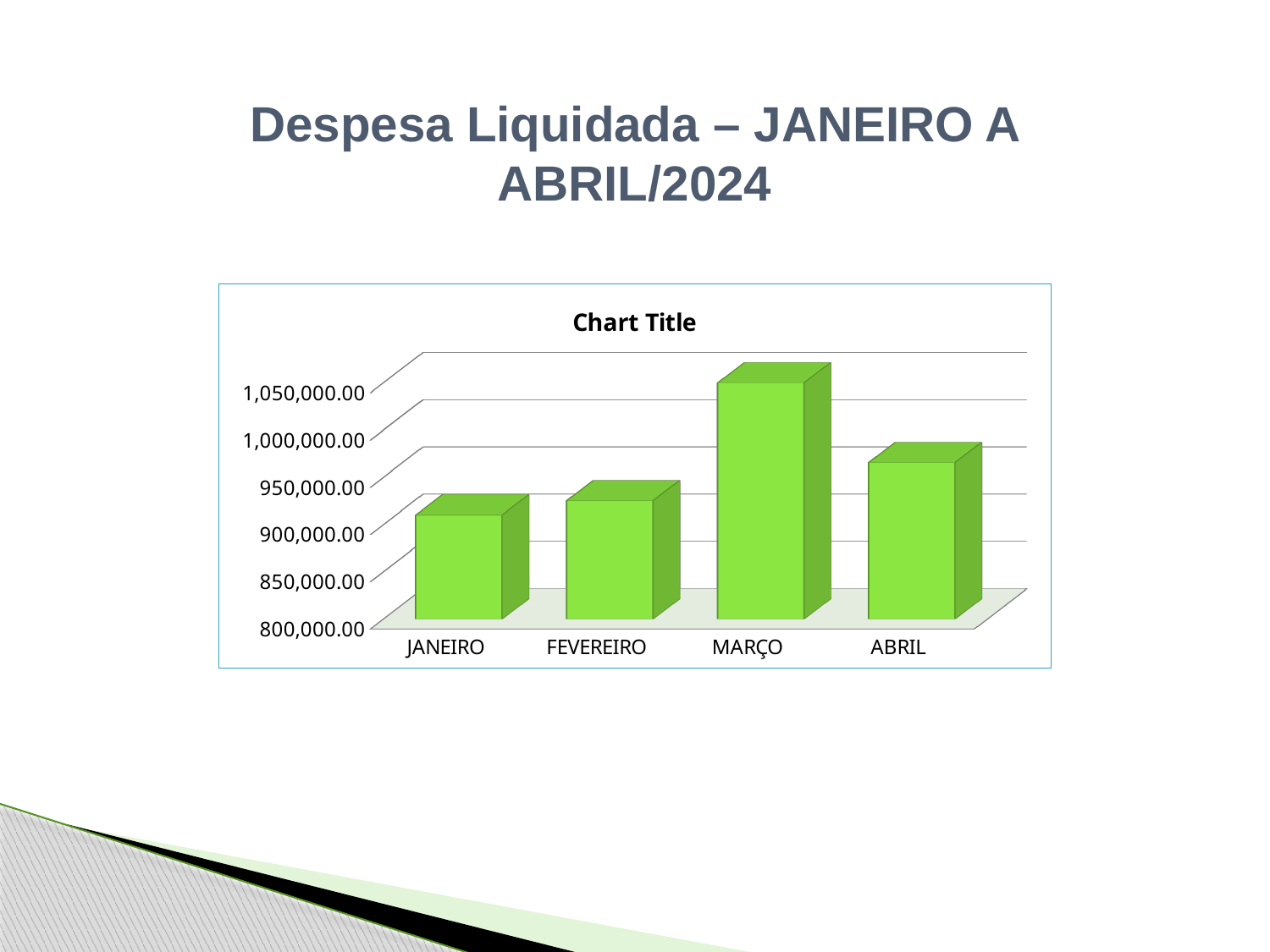
How many months are shown on the x axis of the chart? 4 Is the value for ABRIL greater or less than 1,050,000.00? less Which month has the lowest value in the chart? JANEIRO Does the value rise or fall from FEVEREIRO to MARÇO? rise Which is larger, the value for ABRIL or the value for FEVEREIRO? ABRIL What kind of chart is shown on the slide? bar chart What is the title printed above the chart? Chart Title Which month has the highest value in the chart? MARÇO What colour are the bars in the chart? green Which is larger, the value for MARÇO or the value for ABRIL? MARÇO Is the value for MARÇO greater or less than 1,000,000.00? greater Is the value for JANEIRO greater or less than 1,000,000.00? less